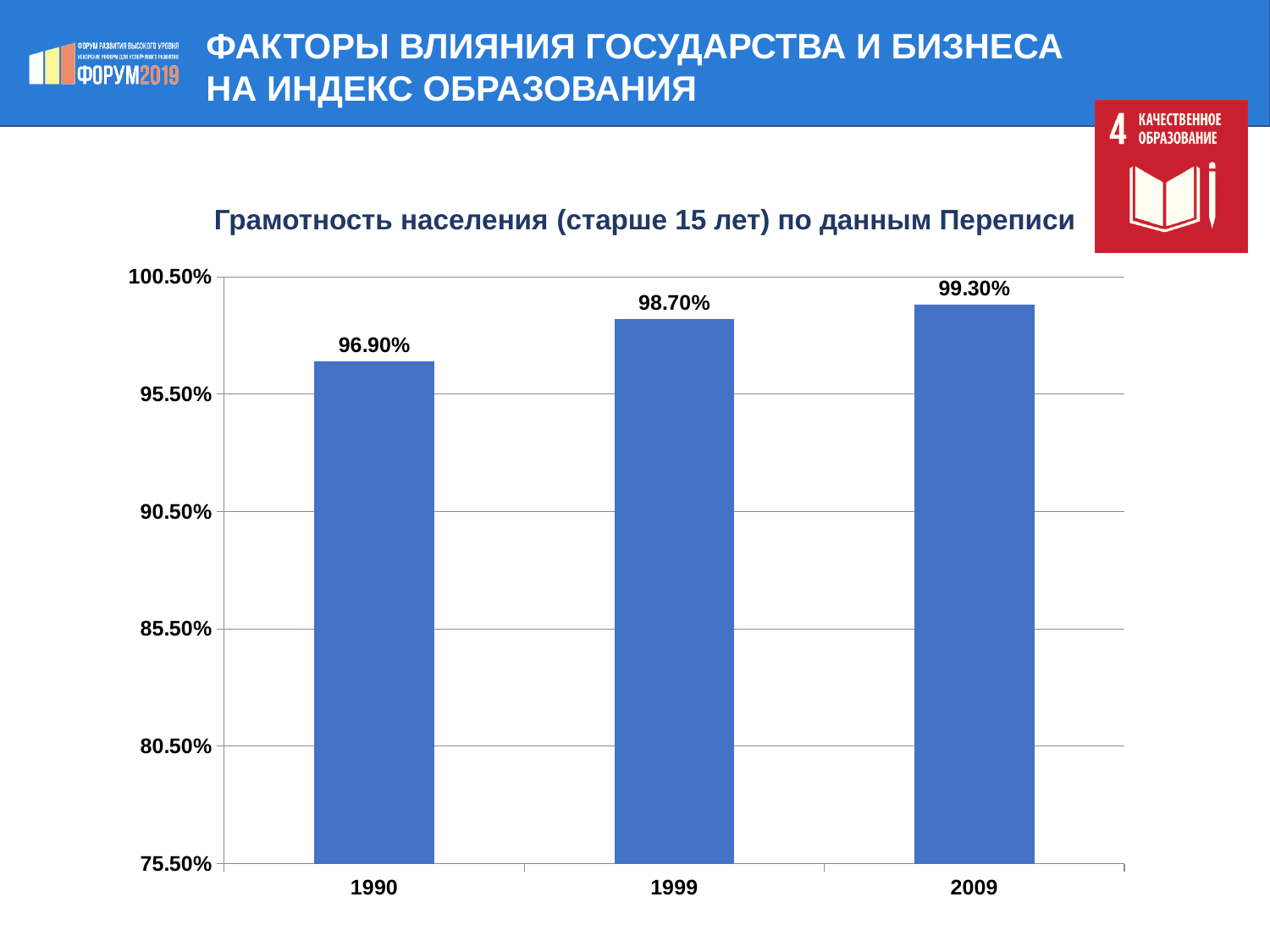
Which year has the highest literacy rate? 2009 What is the literacy rate shown for 1999? 98.70% What is the difference between the literacy rates for 2009 and 1990? 2.40% Which year has the lowest literacy rate? 1990 What is the literacy rate shown for 1990? 96.90% Do the literacy rates rise or fall from 1990 to 2009? rise Is the value for 1990 greater or less than 95.50%? greater What is the literacy rate shown for 2009? 99.30% How many years are shown on the chart? 3 What kind of chart is shown on the slide? bar chart Which is larger, the literacy rate for 1999 or for 2009? 2009 What is the difference between the literacy rates for 1999 and 1990? 1.80%